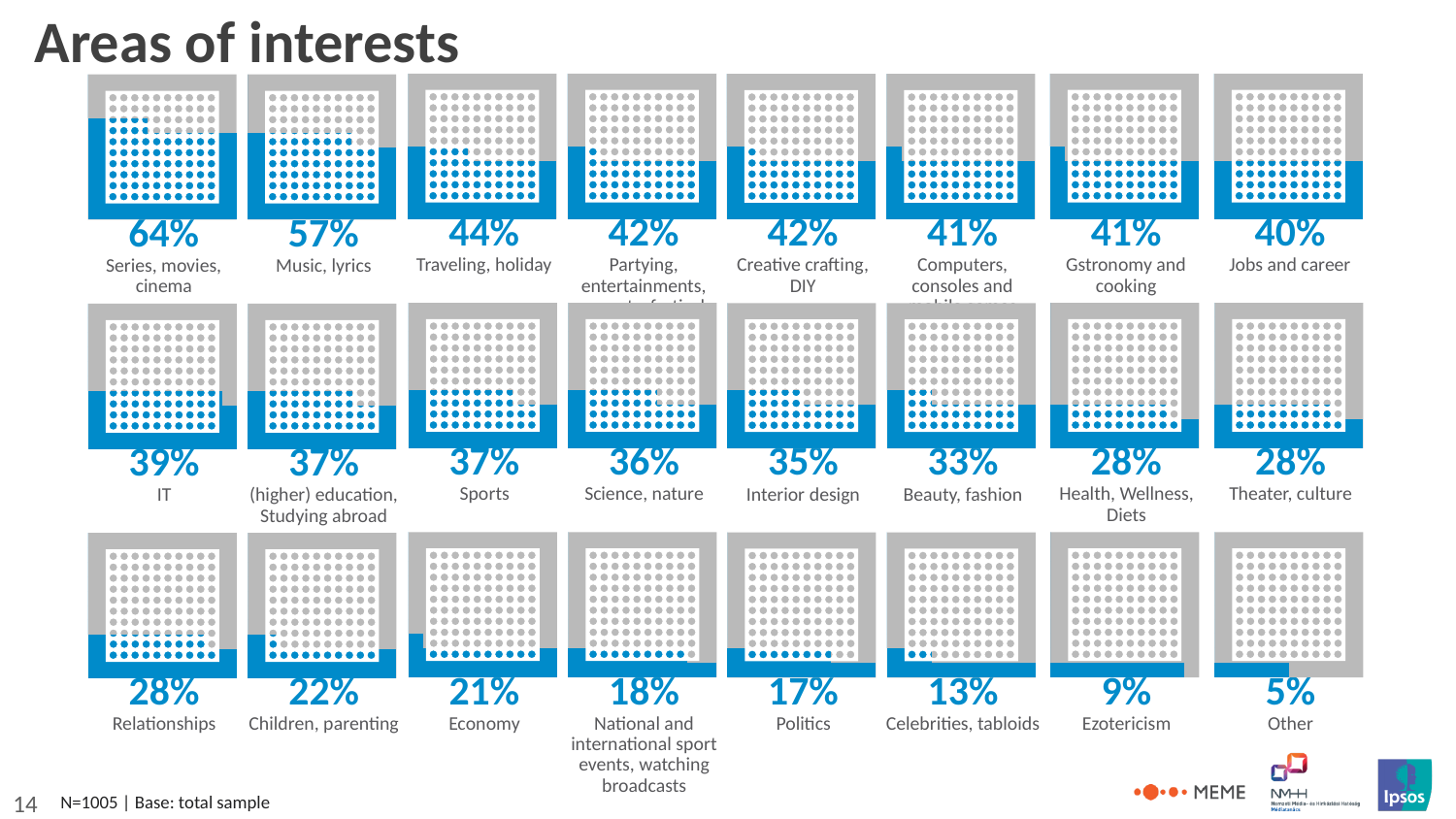
What percentage of respondents are interested in Series, movies, cinema? 64% What is the title of the slide? Areas of interests What percentage is shown for Politics? 17% What is the value for Beauty, fashion? 33% What is the difference in percentage points between Series, movies, cinema and Music, lyrics? 7 How many areas of interest are shown on the slide? 24 What is the value shown for Music, lyrics? 57% Which has a higher value, Traveling, holiday or IT? Traveling, holiday Which area of interest has the lowest percentage? Other Which has a higher value, Celebrities, tabloids or Children, parenting? Children, parenting Which area of interest has the highest percentage? Series, movies, cinema What is the difference in percentage points between Sports and Economy? 16